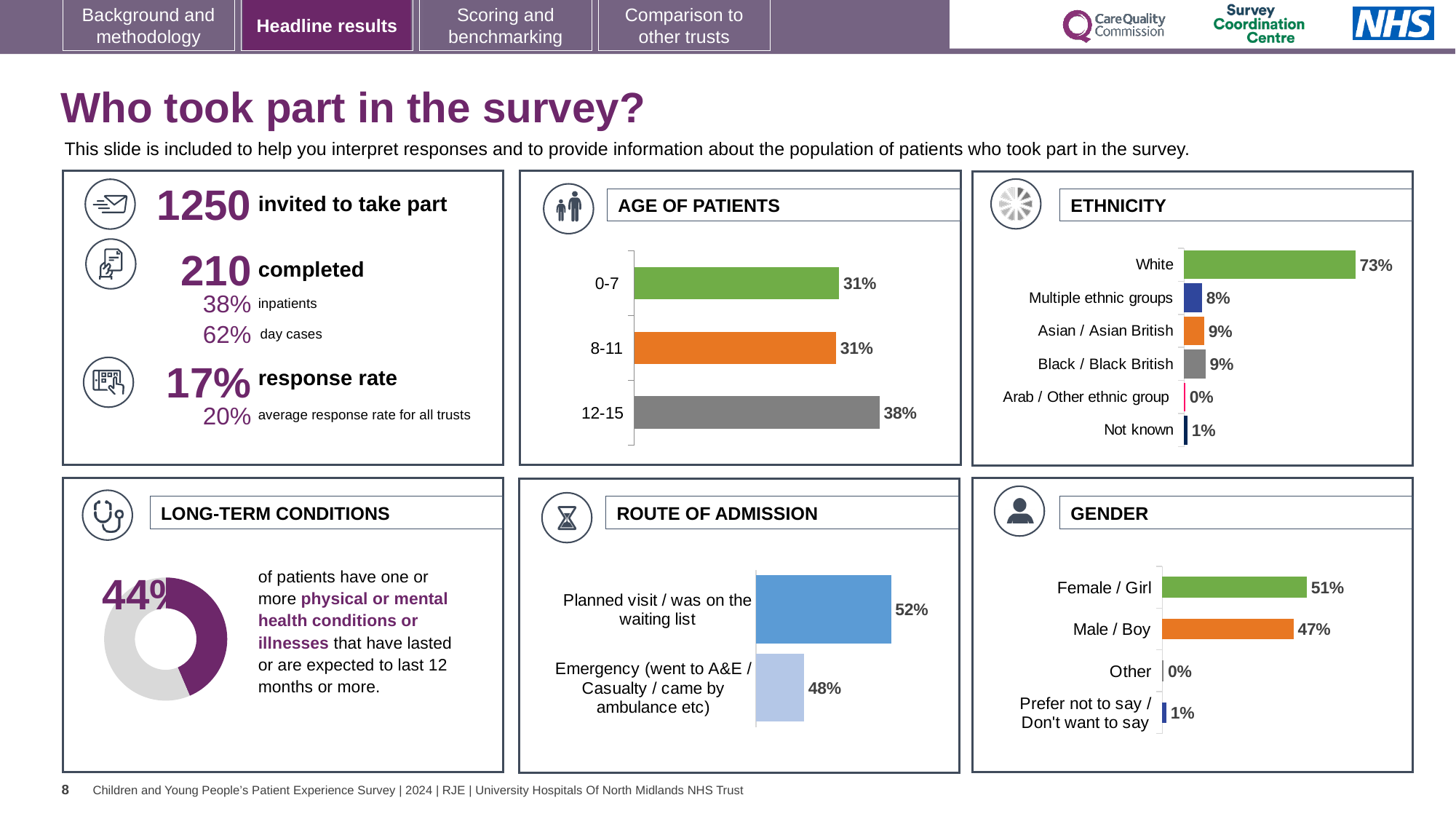
In the ETHNICITY chart, how many ethnicity categories are listed? 6 In the AGE OF PATIENTS chart, what percentage of patients were aged 12-15? 38% In the AGE OF PATIENTS chart, which age group has the highest percentage? 12-15 In the ROUTE OF ADMISSION chart, which route is larger: Planned visit or Emergency? Planned visit / was on the waiting list In the AGE OF PATIENTS chart, how many age groups are shown? 3 In the GENDER chart, what is the difference between the Female / Girl and Male / Boy percentages? 4% In the ETHNICITY chart, what is the difference between the White and Multiple ethnic groups percentages? 65% In the ETHNICITY chart, what percentage of patients were White? 73% In the ROUTE OF ADMISSION chart, what percentage of patients had a planned visit / were on the waiting list? 52% In the GENDER chart, what percentage of patients were Male / Boy? 47% What type of chart is used in the LONG-TERM CONDITIONS panel? Doughnut chart In the ETHNICITY chart, which category has the lowest percentage? Arab / Other ethnic group